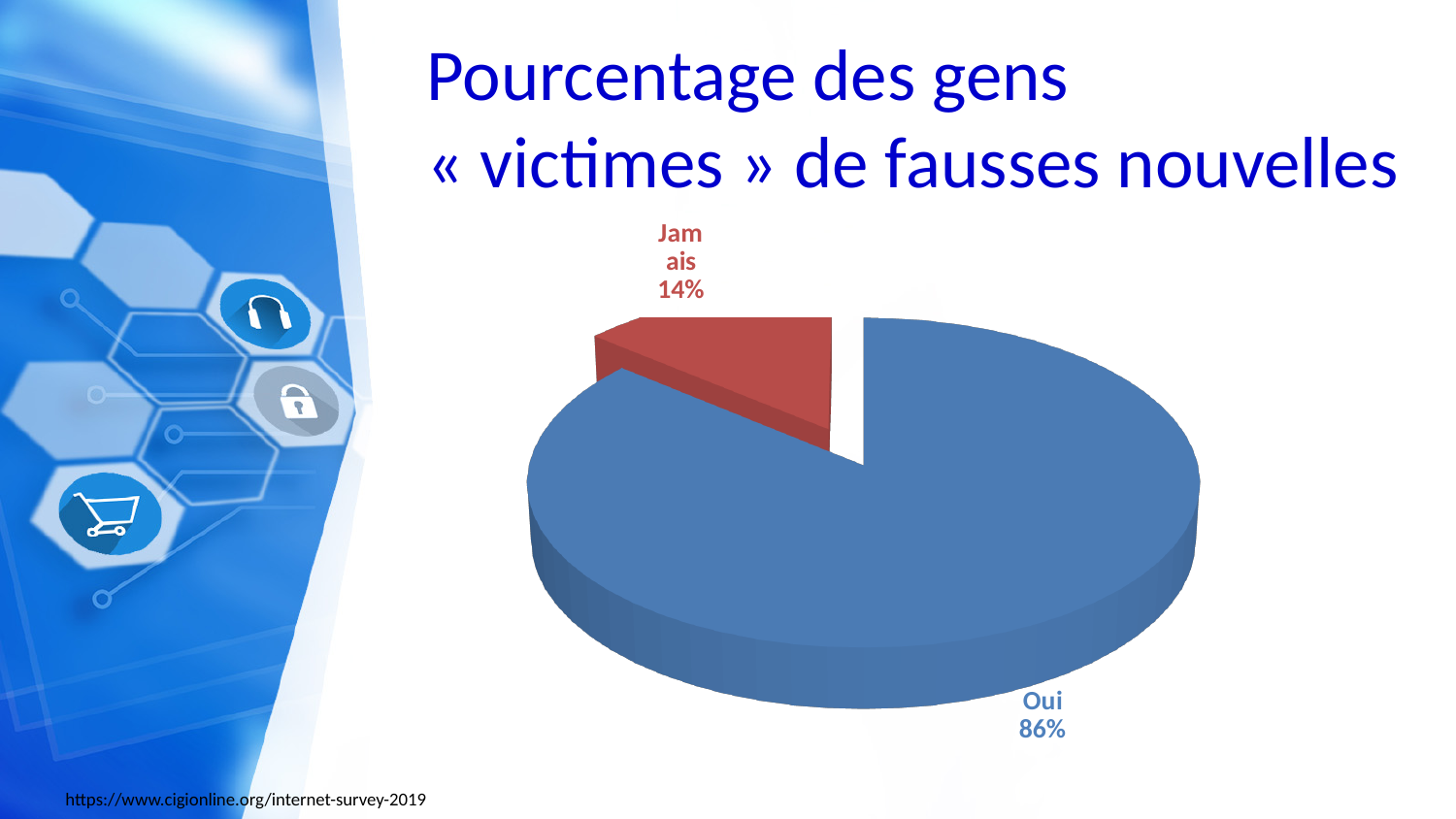
What kind of chart is shown on the slide? pie chart What is the difference in percentage points between the "Oui" slice and the "Jamais" slice? 72 What percentage of the pie is labelled "Jamais"? 14% What share of the pie does the "Jamais" slice represent? 14% Is the value for "Oui" greater or less than 50%? greater How many slices does the pie chart have? 2 What is the title of the slide containing the pie chart? Pourcentage des gens « victimes » de fausses nouvelles What colour is the "Jamais" slice? red Which slice of the pie is the largest? Oui What percentage of the pie is labelled "Oui"? 86% Which is larger, the "Oui" slice or the "Jamais" slice? Oui Which slice of the pie is the smallest? Jamais